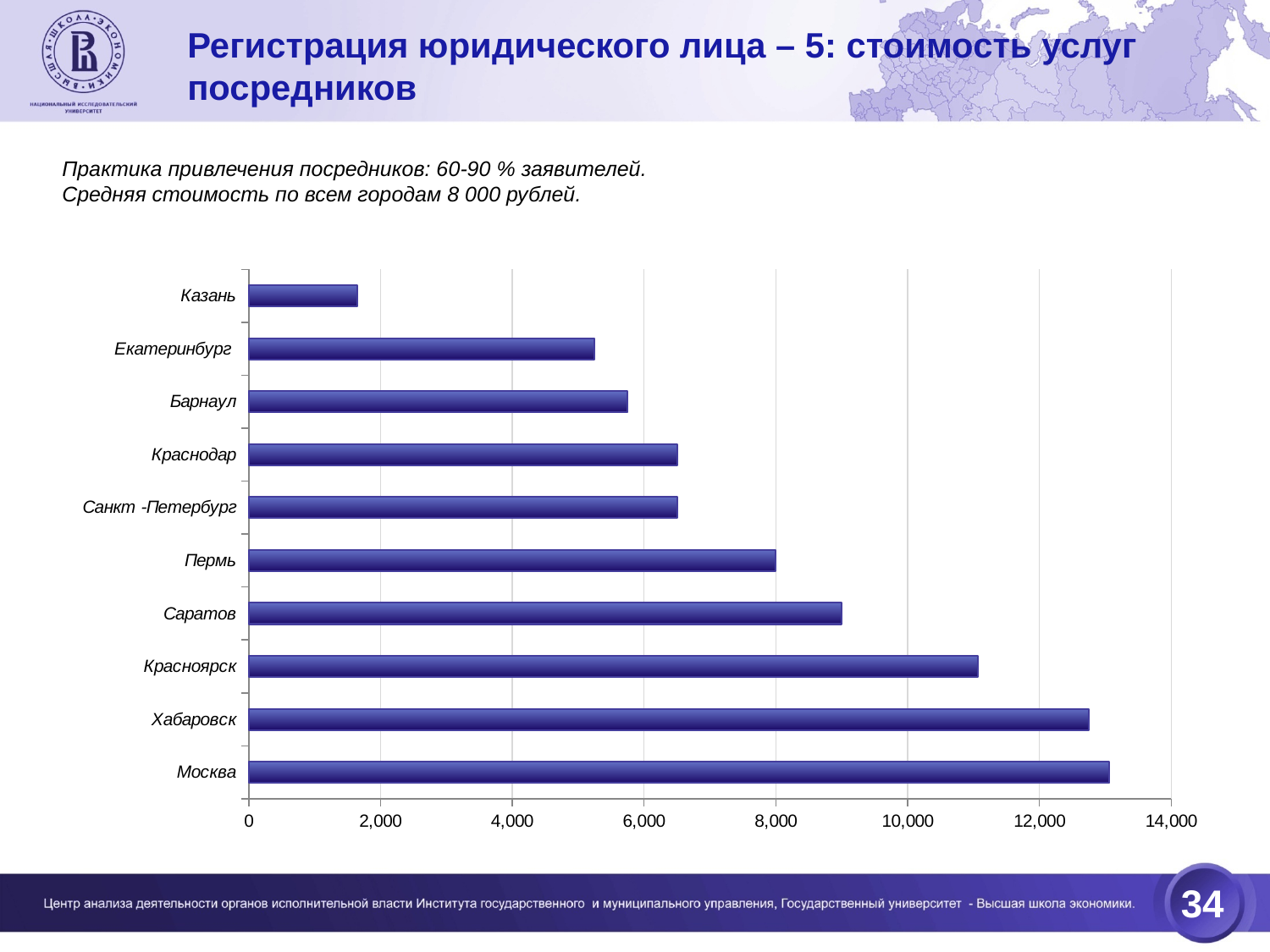
Is the value for Хабаровск greater or less than 12,000? greater Which has the larger value, Барнаул or Екатеринбург? Барнаул Is the value for Казань greater or less than 2,000? less Which city has the highest value in the chart? Москва Do the bar values increase or decrease going down the chart from Казань to Москва? increase Is the value for Красноярск greater or less than 10,000? greater Which city has the lowest value in the chart? Казань Which has the larger value, Красноярск or Саратов? Красноярск How many cities are shown in the chart? 10 What kind of chart is shown on the slide? bar chart